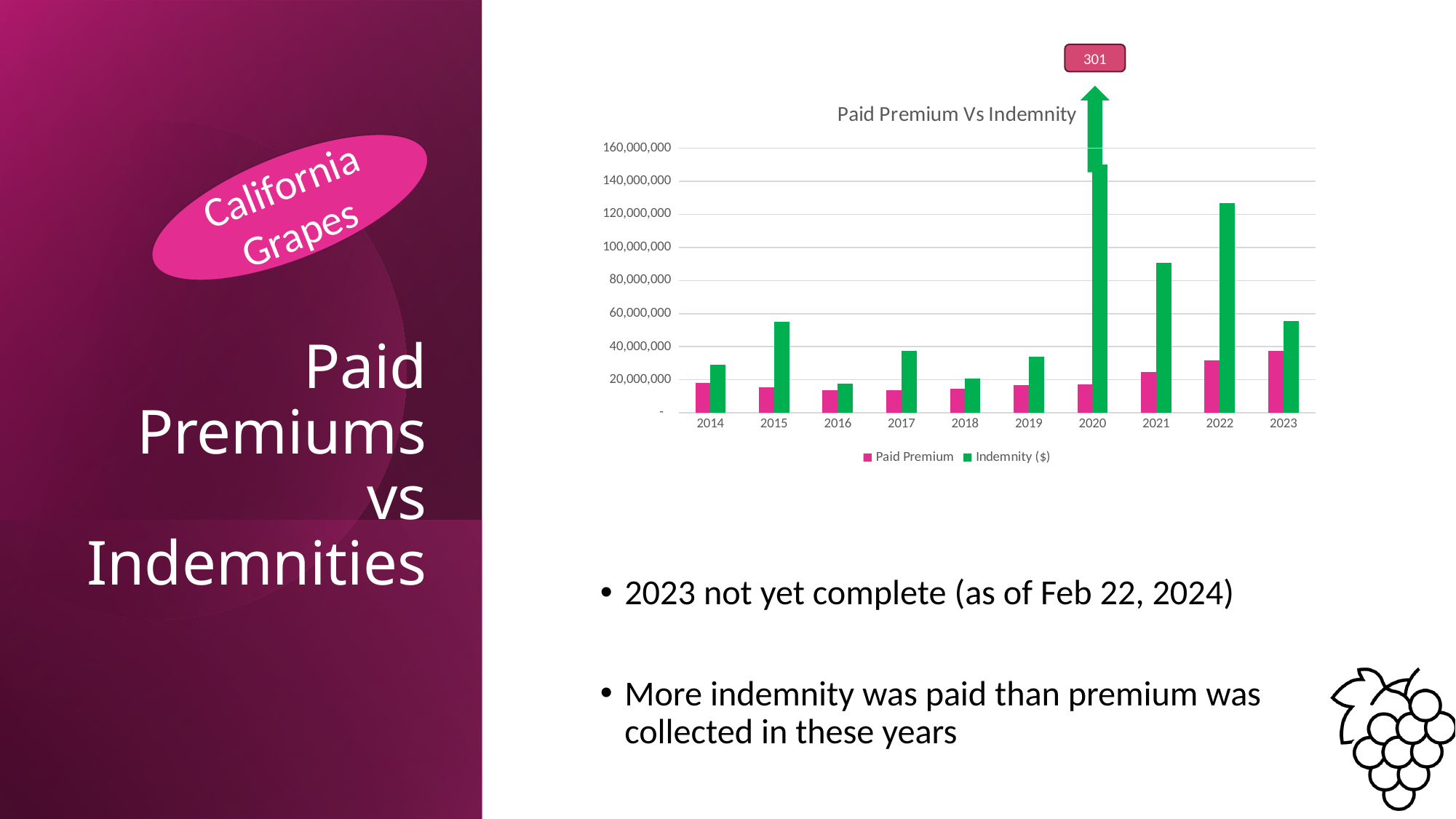
How many years are shown on the x axis of the Paid Premium Vs Indemnity chart? 10 Is the Indemnity ($) value for 2022 greater or less than 100,000,000? greater In 2015, which is larger: Paid Premium or Indemnity ($)? Indemnity ($) What kind of chart is shown on the slide? Bar chart Is the Paid Premium value for 2022 greater or less than 40,000,000? less How many series does the legend of the Paid Premium Vs Indemnity chart list? 2 Is the Indemnity ($) value for 2014 greater or less than 20,000,000? greater In which year is the Paid Premium value highest? 2023 What colour are the Indemnity ($) bars in the chart? Green Does the Paid Premium value rise or fall from 2019 to 2023? Rise In which year is the Indemnity ($) value highest? 2020 Which year has the larger Indemnity ($) value, 2021 or 2022? 2022